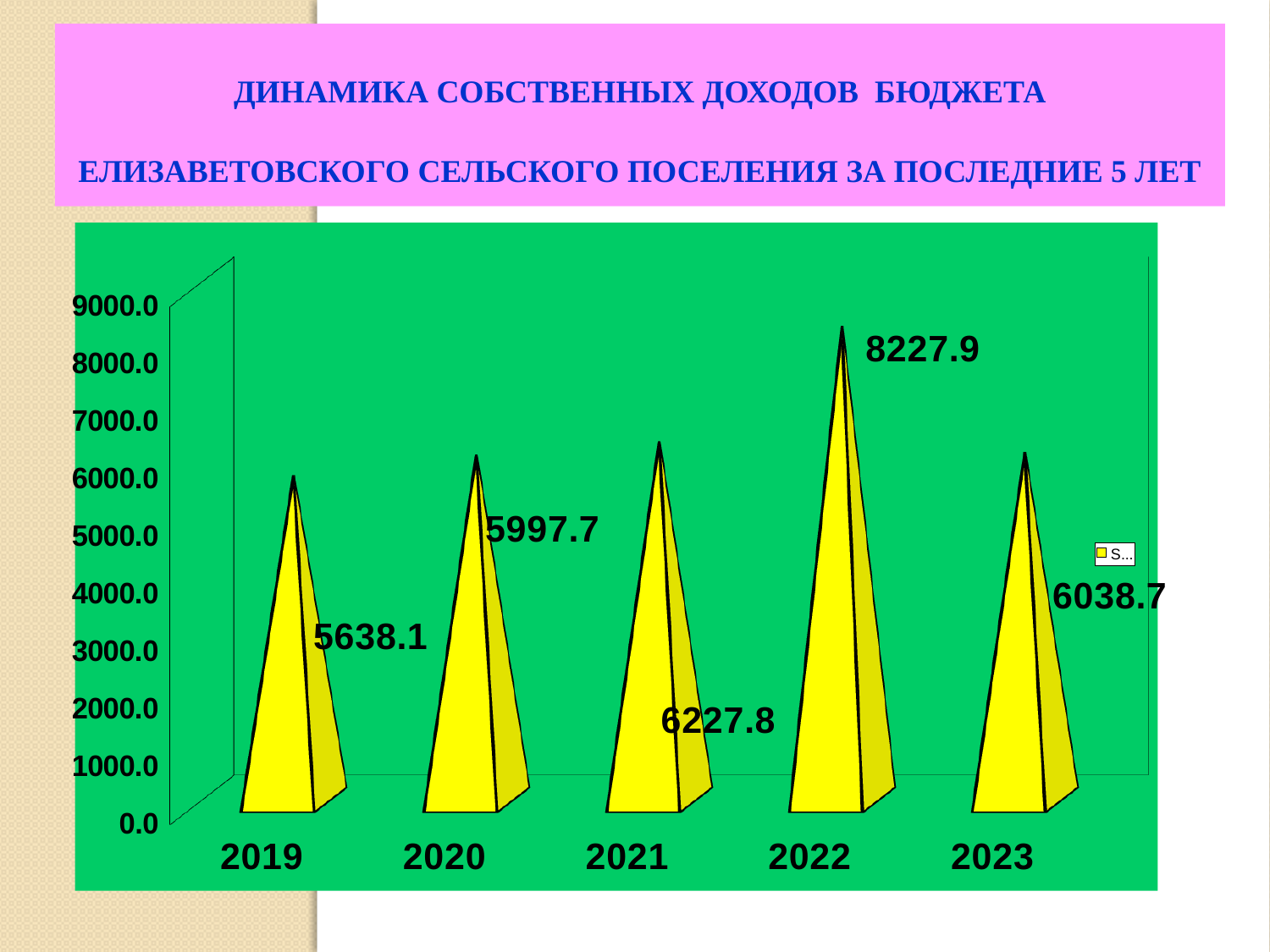
Do the values rise or fall from 2019 to 2022? rise Which year has the lowest value? 2019 What is the value for 2021? 6227.8 What is the difference between the values for 2022 and 2019? 2589.8 What is the difference between the values for 2021 and 2020? 230.1 Which is larger, the value for 2020 or the value for 2023? 2023 What is the value for 2022? 8227.9 What is the value for 2019? 5638.1 What is the value for 2023? 6038.7 Is the value for 2022 greater or less than 7000.0? greater Which year has the highest value? 2022 How many years are shown on the x axis? 5